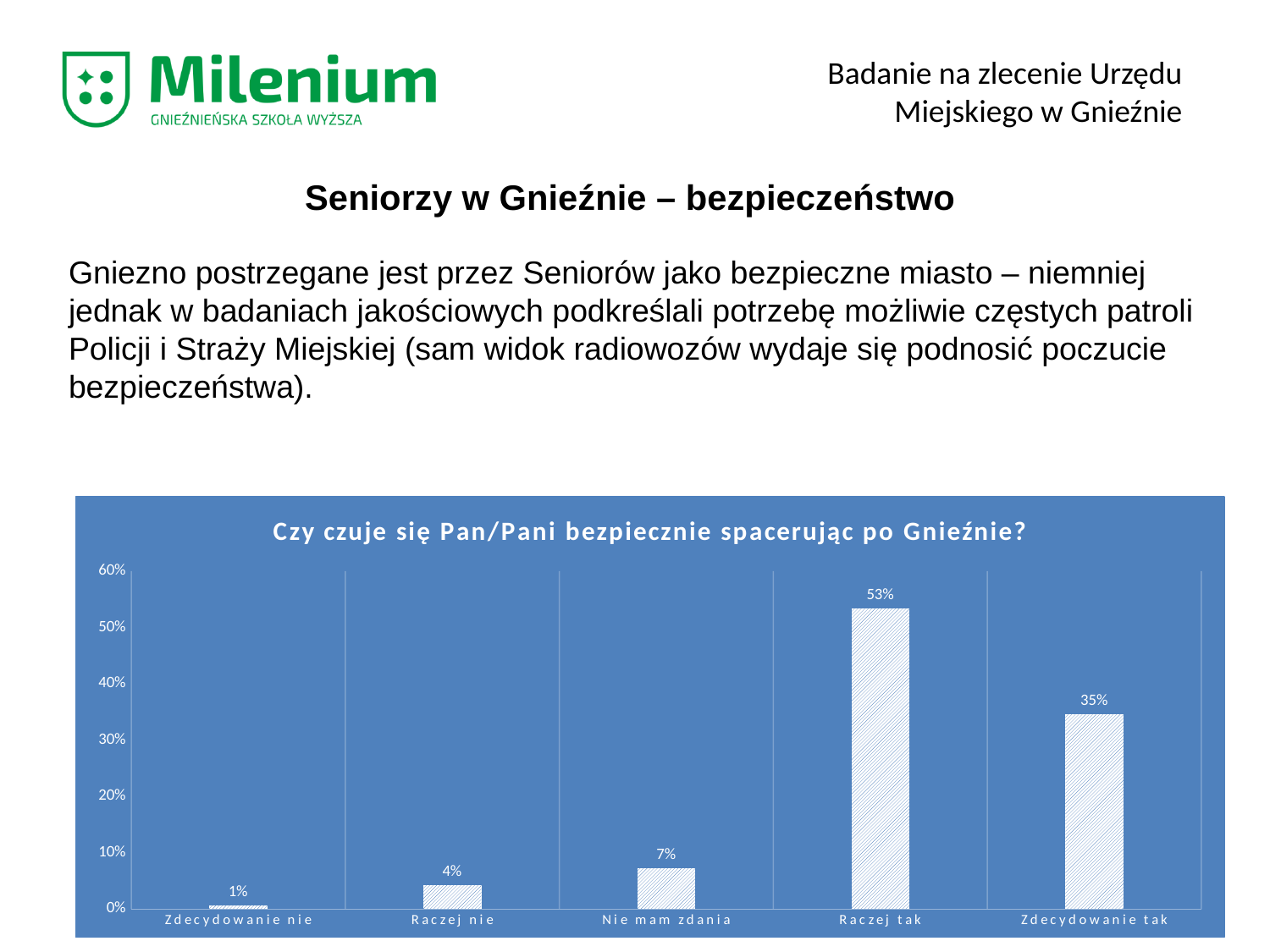
What is the value for "Nie mam zdania"? 7% What kind of chart is shown on the slide? bar chart What is the value for "Raczej tak"? 53% What is the value for "Zdecydowanie nie"? 1% Which category has the lowest value? Zdecydowanie nie Is the value for "Raczej tak" greater or less than 50%? greater What is the title of the chart? Czy czuje się Pan/Pani bezpiecznie spacerując po Gnieźnie? Which is larger, the value for "Raczej nie" or the value for "Nie mam zdania"? Nie mam zdania What is the difference between the values for "Raczej tak" and "Zdecydowanie tak"? 18% What is the value for "Zdecydowanie tak"? 35% How many categories are shown on the x axis? 5 Which category has the highest value? Raczej tak